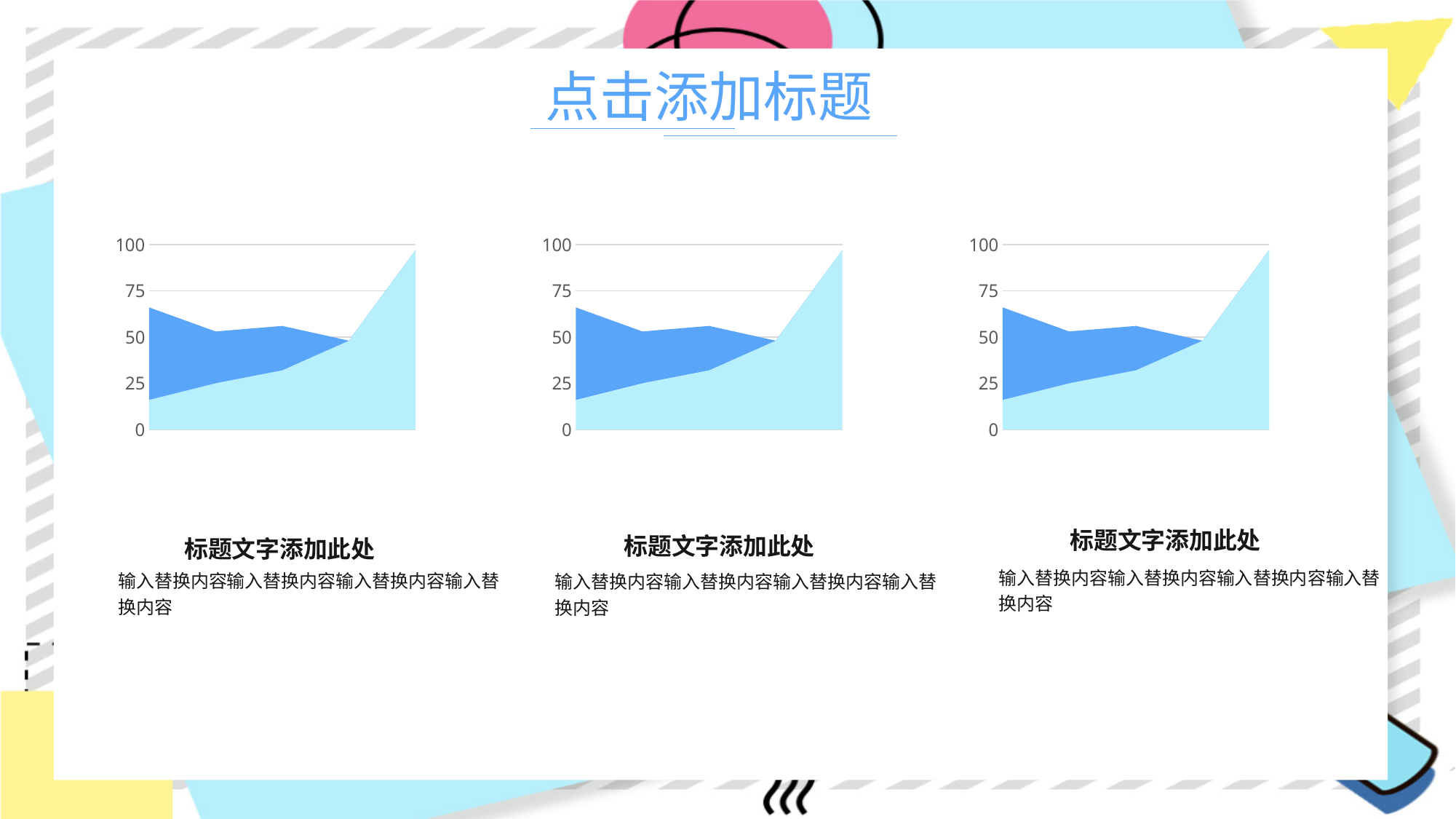
In the left chart, does the light blue area rise or fall from left to right along the x axis? rises How many charts are shown on the slide? 3 In the middle chart, is the value of the light blue area at its rightmost point greater or less than 75? greater How many data points does the light blue area in the left chart have along the x axis? 5 What kind of chart is the left chart on the slide? area chart In the left chart, what is the highest value shown on the vertical axis? 100 In the left chart, is the top of the dark blue area at its leftmost point greater or less than 50? greater What kind of chart is the middle chart on the slide? area chart In the right chart, is the value of the light blue area at its leftmost point greater or less than 25? less What kind of chart is the right chart on the slide? area chart